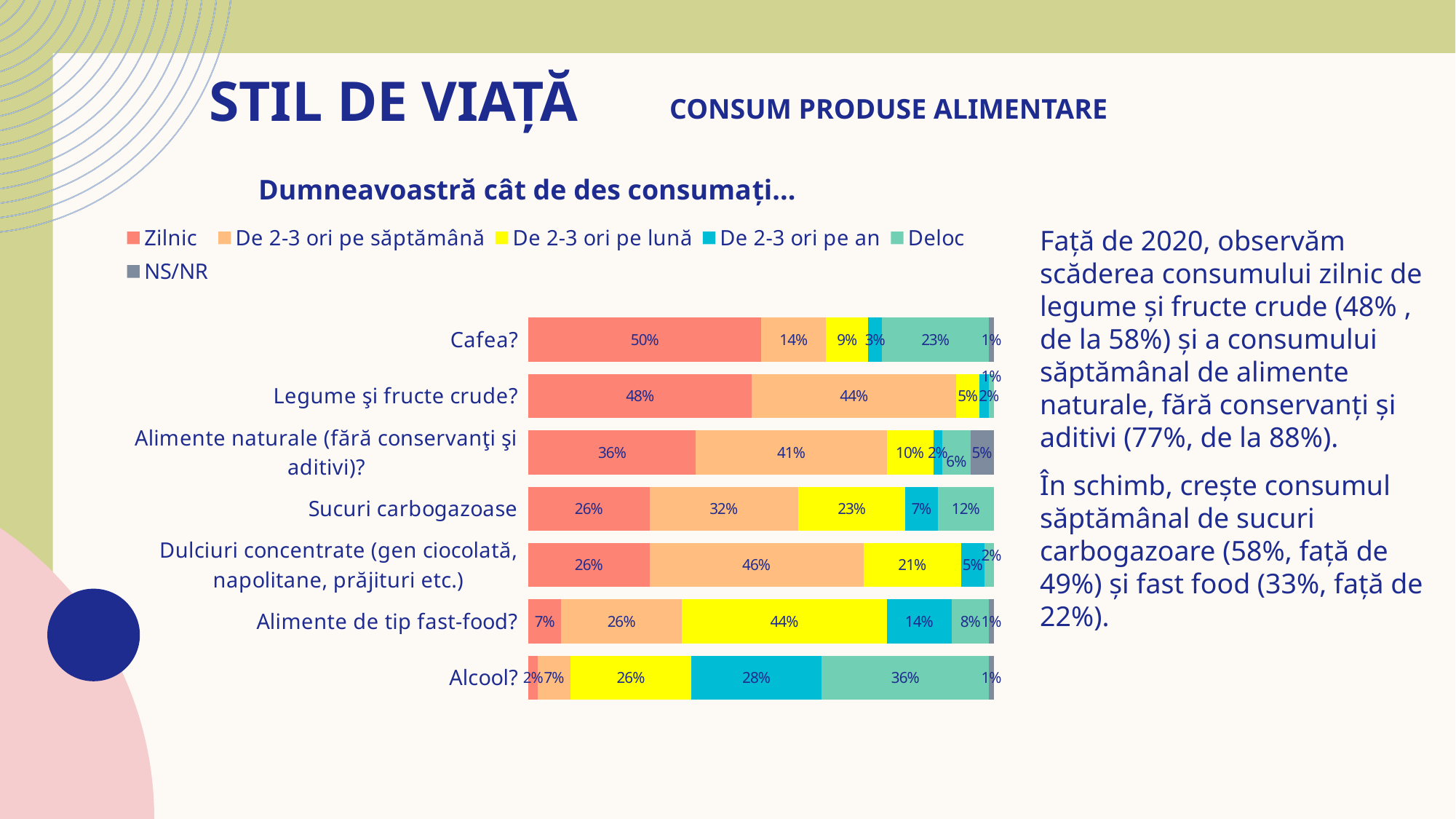
Which is larger: the 'De 2-3 ori pe săptămână' value for 'Dulciuri concentrate (gen ciocolată, napolitane, prăjituri etc.)' or for 'Sucuri carbogazoase'? Dulciuri concentrate (gen ciocolată, napolitane, prăjituri etc.) How many series does the legend list? 6 Which category has the highest 'Zilnic' value? Cafea? What is the question shown as the chart's title? Dumneavoastră cât de des consumați… What is the difference between the 'Zilnic' values for 'Cafea?' and 'Alimente naturale (fără conservanţi şi aditivi)?' 14% What is the 'Zilnic' value for 'Cafea?' 50% What is the 'De 2-3 ori pe săptămână' value for 'Legume şi fructe crude?' 44% How many categories (food items) are shown on the chart? 7 What kind of chart is shown on the slide? stacked bar chart What is the 'De 2-3 ori pe lună' value for 'Alimente de tip fast-food?' 44% Which category has the lowest 'Zilnic' value? Alcool? What is the 'Deloc' value for 'Alcool?' 36%